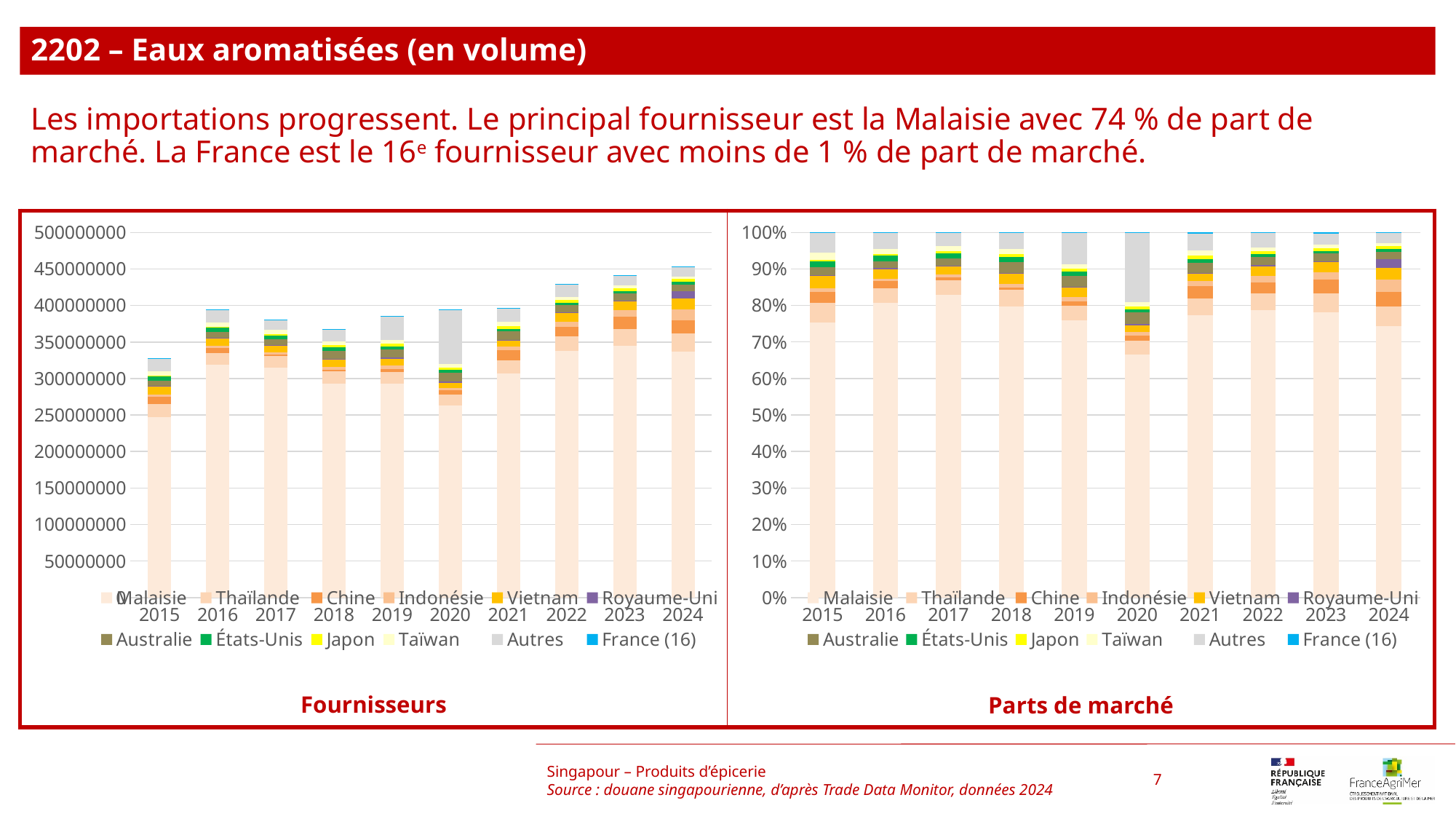
Which series is listed last in the legend of the 'Fournisseurs' chart? France (16) In the 'Fournisseurs' chart, which year has the highest total bar? 2024 In the 'Parts de marché' chart, is the share of Malaisie in 2020 greater or less than 70%? less In the 'Parts de marché' chart, is the share of Malaisie in 2024 greater or less than 70%? greater In the 'Fournisseurs' chart, do the total bars generally rise or fall from 2015 to 2024? Rise How many years are shown on the x axis of the 'Fournisseurs' chart? 10 In the 'Fournisseurs' chart, which year has the lowest total bar? 2015 How many series does the legend of the 'Parts de marché' chart list? 12 In the 'Fournisseurs' chart, which total bar is larger, 2019 or 2022? 2022 What type of chart is the 'Fournisseurs' chart on the left? Stacked bar chart In the 'Fournisseurs' chart, is the total for 2022 greater or less than 400000000? greater